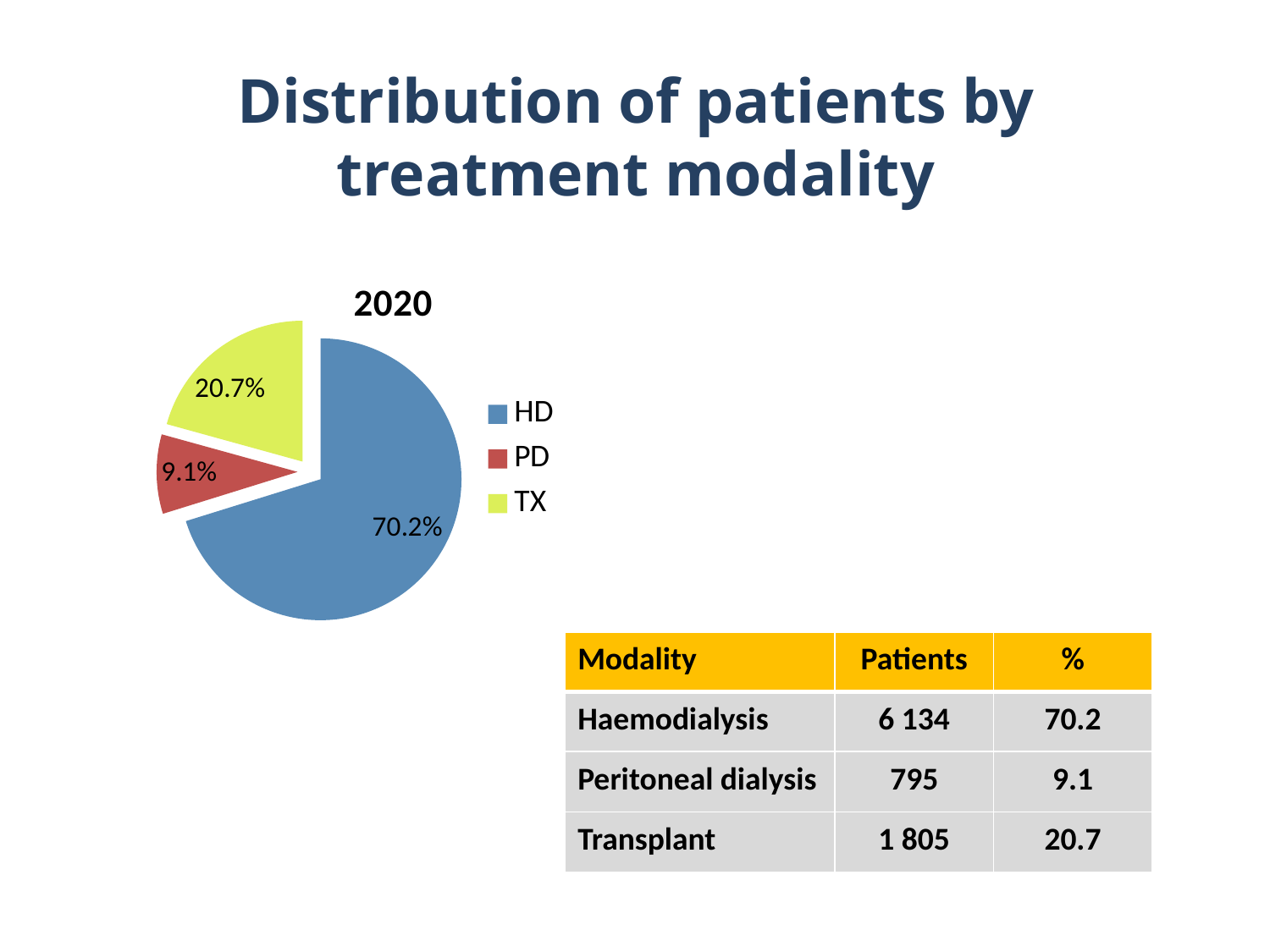
What is the chart's title? 2020 Which slice of the pie is the smallest? PD What share of the pie does HD have? 70.2% What is the difference in percentage points between the HD slice and the TX slice? 49.5 How many slices does the pie chart have? 3 What share of the pie does PD have? 9.1% What colour is the TX slice? yellow-green What share of the pie does TX have? 20.7% What kind of chart is shown on the slide? pie chart Which slice of the pie is the largest? HD Which is larger, the TX slice or the PD slice? TX How many entries does the legend list? 3